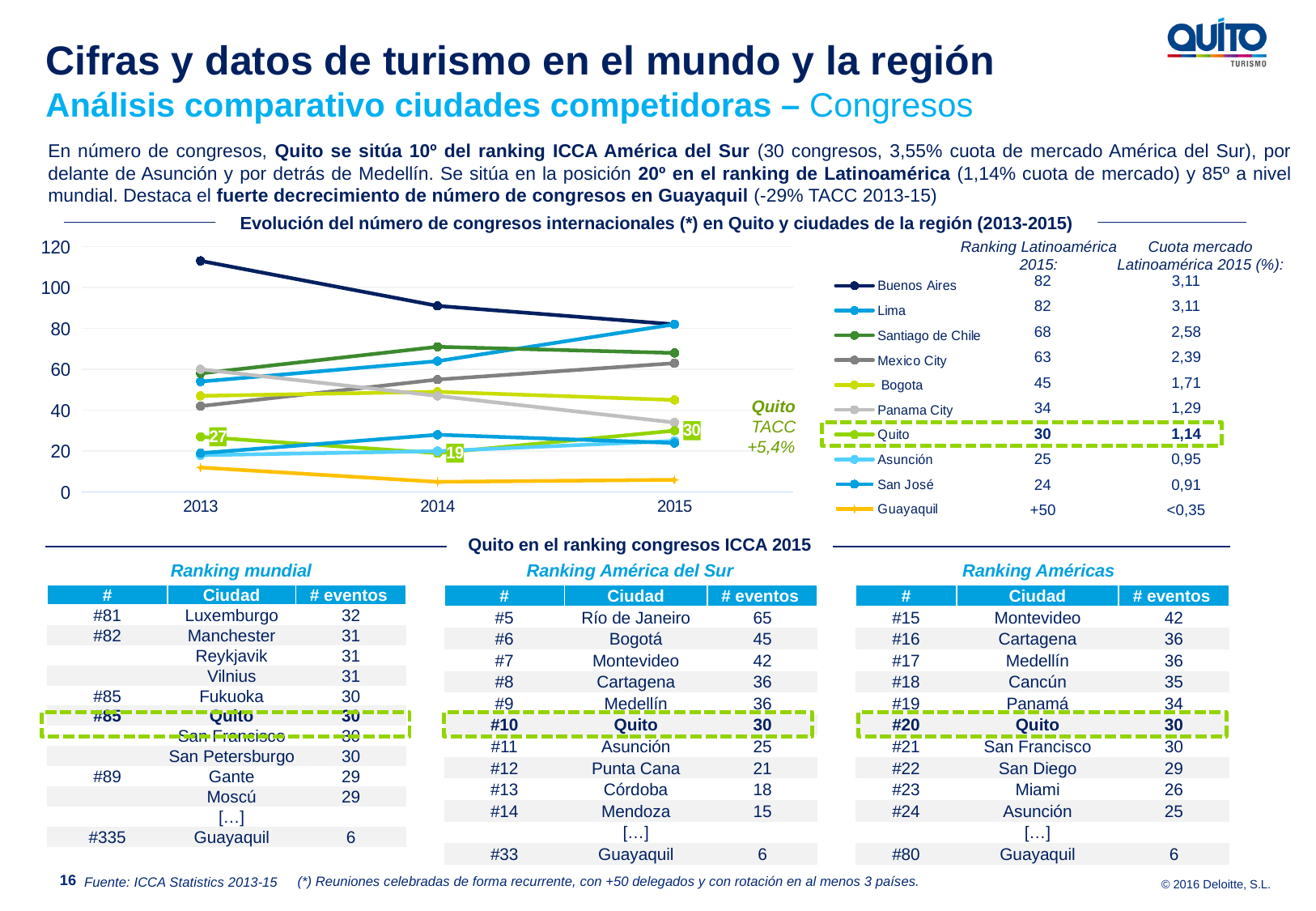
Does the Buenos Aires line rise or fall from 2013 to 2015? fall What kind of chart is shown on the slide? line chart What is the value for Quito in 2013 in the line chart? 27 How many years are plotted along the x axis of the line chart? 3 What is the value for Quito in 2014 in the line chart? 19 Is the value for Buenos Aires in 2013 greater or less than 100? greater Which city has the lowest value in 2015 in the line chart? Guayaquil How many series does the legend of the line chart list? 10 What is the value for Quito in 2015 in the line chart? 30 Which city has the highest value in 2013 in the line chart? Buenos Aires By how much did Quito's value increase from 2014 to 2015 in the line chart? 11 What is the title of the line chart? Evolución del número de congresos internacionales (*) en Quito y ciudades de la región (2013-2015)